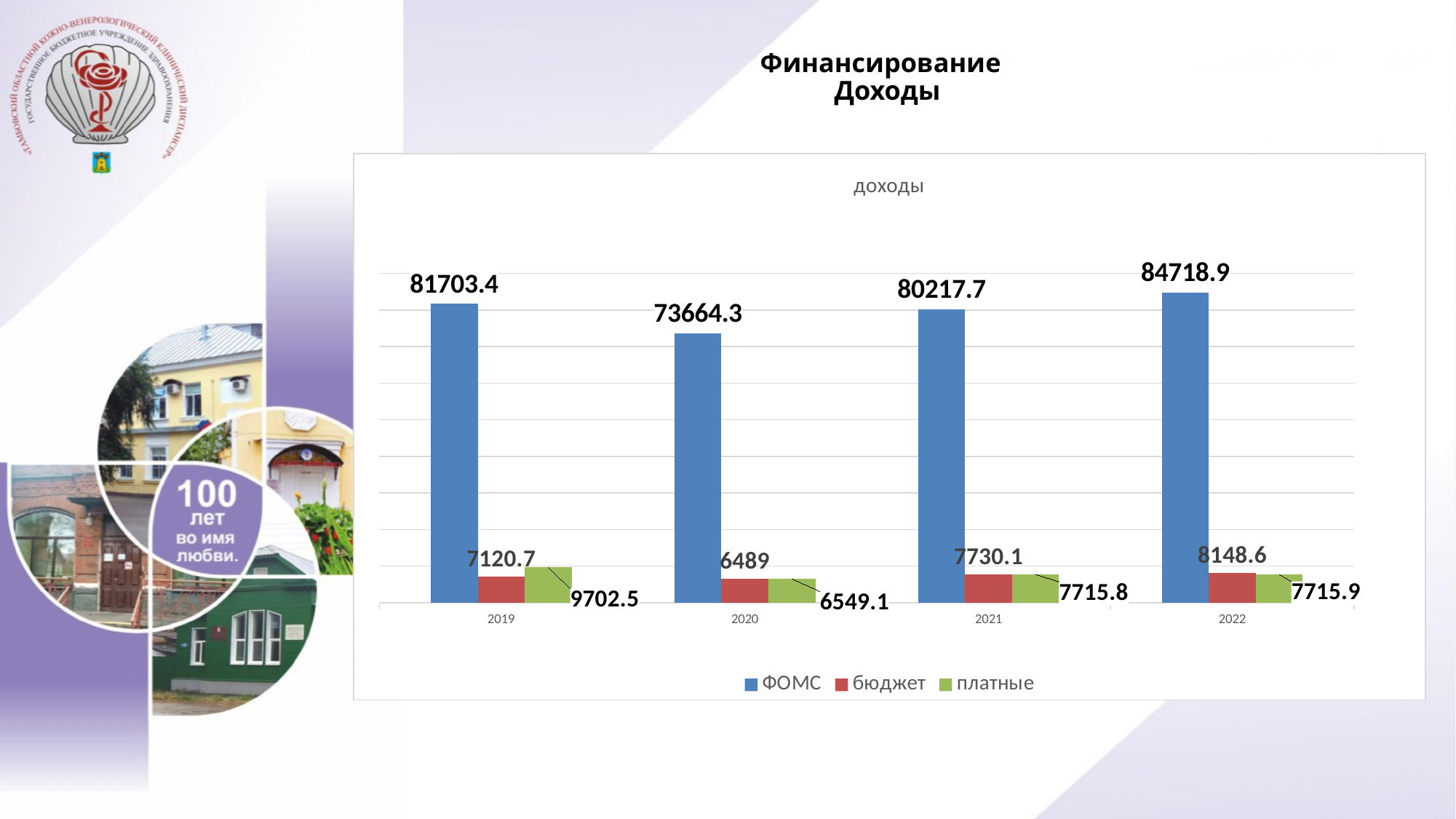
In 2019, which is larger: бюджет or платные? платные What kind of chart is this? bar chart How many years are shown on the x axis? 4 What is the value of бюджет for 2020? 6489 In which year is the ФОМС value highest? 2022 What is the value of платные for 2019? 9702.5 What is the value of ФОМС for 2022? 84718.9 Does the ФОМС value rise or fall from 2020 to 2022? rise What is the difference between the ФОМС values for 2022 and 2019? 3015.5 In which year is the ФОМС value lowest? 2020 How many series does the legend list? 3 What is the difference between платные and бюджет in 2019? 2581.8